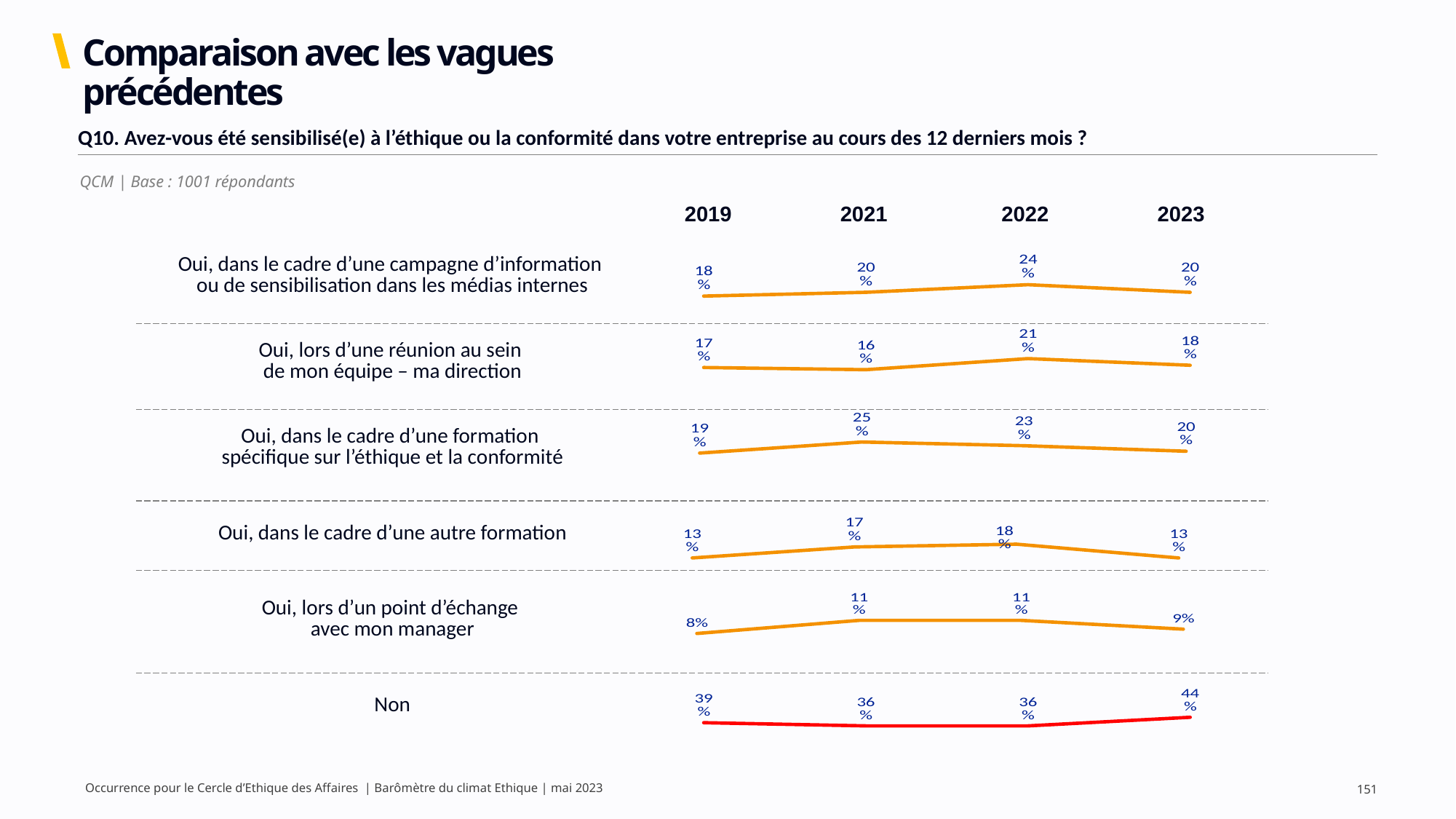
In the row "Oui, dans le cadre d'une autre formation", does the value rise or fall from 2022 to 2023? Fall In the row "Non", which year has the highest value? 2023 In the row "Oui, dans le cadre d'une formation spécifique sur l'éthique et la conformité", which is larger, the 2021 value or the 2023 value? 2021 In the row "Oui, dans le cadre d'une formation spécifique sur l'éthique et la conformité", which year has the highest value? 2021 In the row "Non", what is the value for 2023? 44% In the row "Oui, lors d'un point d'échange avec mon manager", what is the value for 2019? 8% In the row "Non", what is the difference between the 2023 value and the 2022 value? 8% What kind of chart is used in each row of the slide? Line chart In the row "Oui, dans le cadre d'une campagne d'information ou de sensibilisation dans les médias internes", what is the value for 2022? 24% In the row "Oui, lors d'une réunion au sein de mon équipe – ma direction", which year has the lowest value? 2021 In the row "Oui, dans le cadre d'une autre formation", what is the difference between the 2022 value and the 2019 value? 5% How many years (waves) are compared in each row of the slide? 4